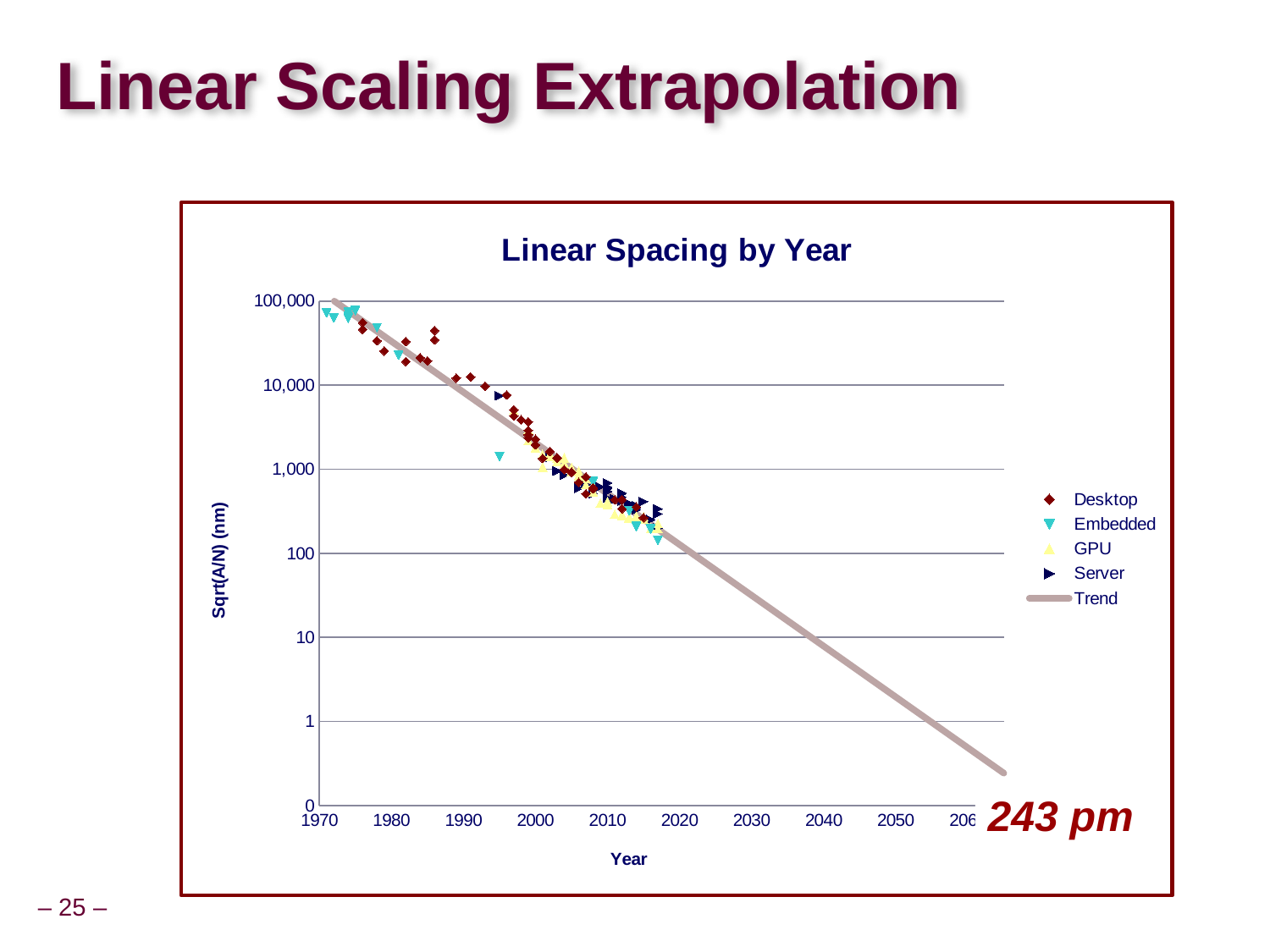
Is the Trend line value at 2030 greater or less than 100? less Is the Trend line value at 2060 greater or less than 1? less Are the Desktop values plotted around 1980 greater or less than 10,000? greater How many entries does the legend of the chart list? 5 What kind of chart is shown on the slide? scatter chart What is the title of the chart? Linear Spacing by Year Do the plotted values rise or fall as the year increases along the x axis? fall What is the label of the y axis of the chart? Sqrt(A/N) (nm)